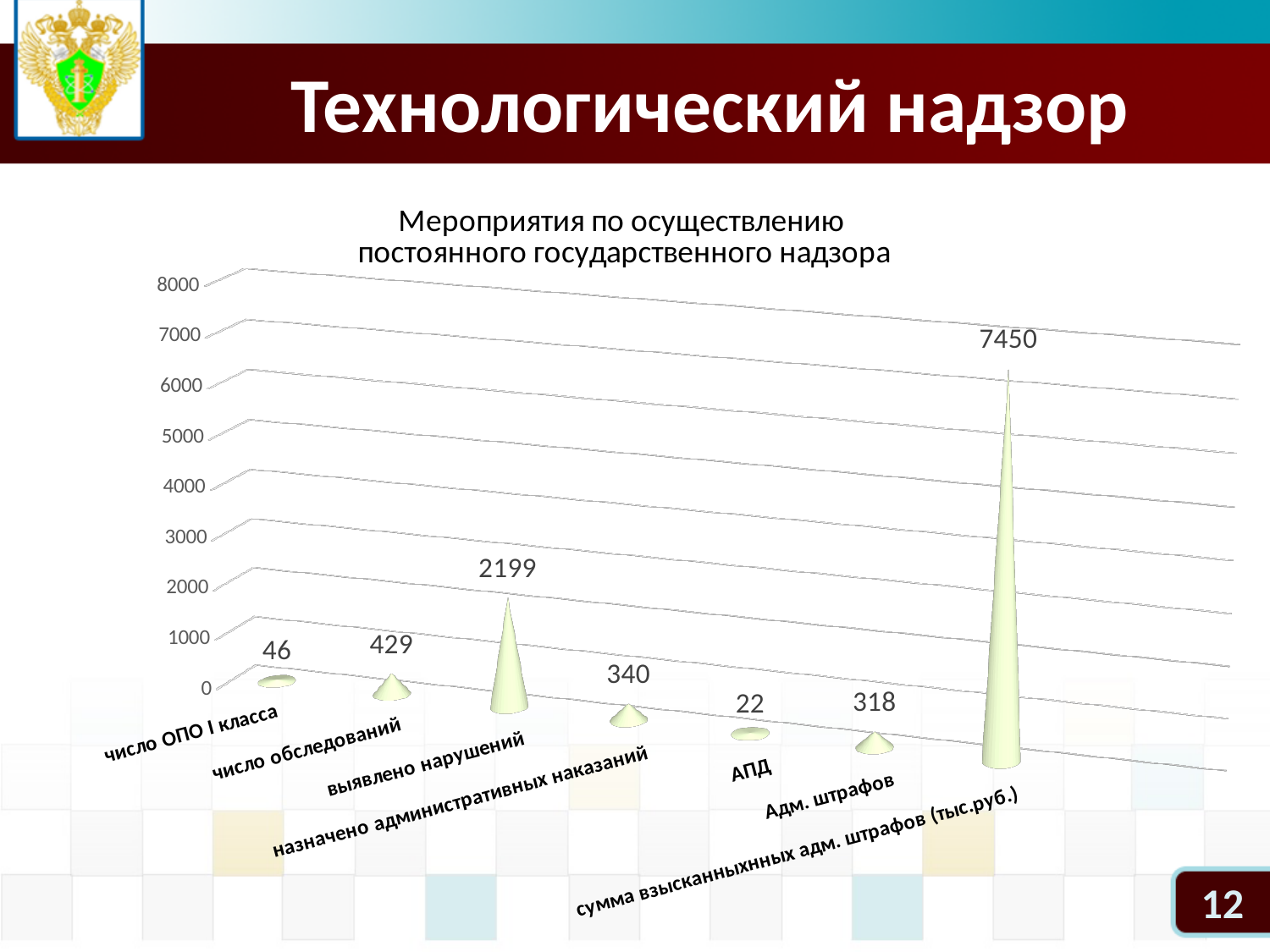
Which is larger: the value for «число обследований» or the value for «назначено административных наказаний»? число обследований What is the difference between the values for «назначено административных наказаний» and «Адм. штрафов»? 22 What is the value for «сумма взысканныхнных адм. штрафов (тыс.руб.)»? 7450 Which category has the lowest value? АПД How many categories are shown on the chart? 7 What kind of chart is shown on the slide? bar chart What is the value for «АПД»? 22 What is the value for «число обследований»? 429 What is the value for «число ОПО I класса»? 46 Which category has the highest value? сумма взысканныхнных адм. штрафов (тыс.руб.) What is the title of the chart? Мероприятия по осуществлению постоянного государственного надзора What is the value for «выявлено нарушений»? 2199